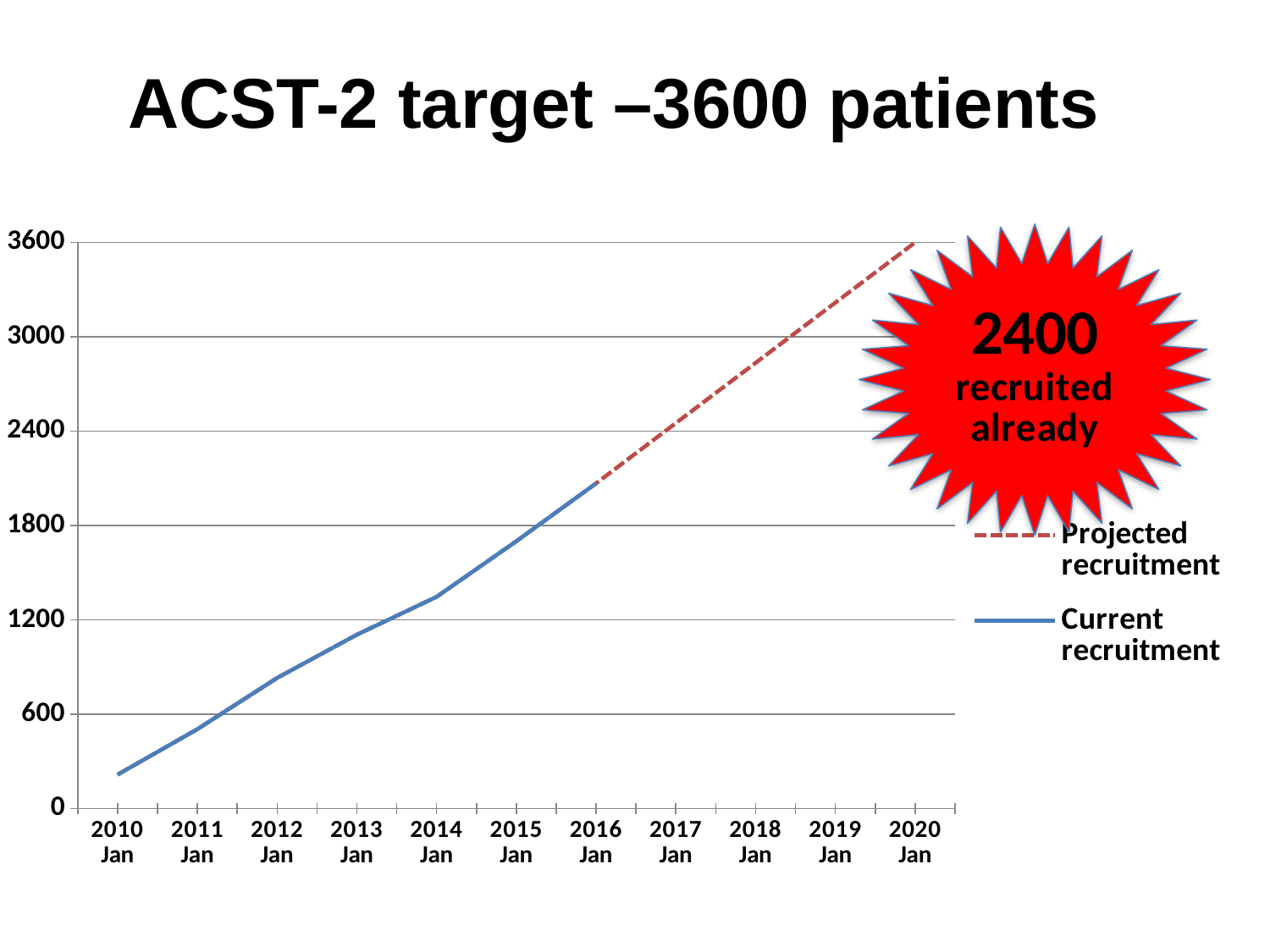
What is the title of the slide containing the chart? ACST-2 target –3600 patients Does the Current recruitment line rise or fall from 2010 Jan to 2016 Jan? rises Is the Projected recruitment value at 2018 Jan greater or less than 2400? greater Is the Current recruitment value at 2014 Jan greater or less than 1200? greater Is the Current recruitment value at 2016 Jan greater or less than 1800? greater How many year labels are shown along the x axis? 11 Which series is drawn with a dashed line? Projected recruitment What kind of chart is shown on the slide? line chart How many series does the legend list? 2